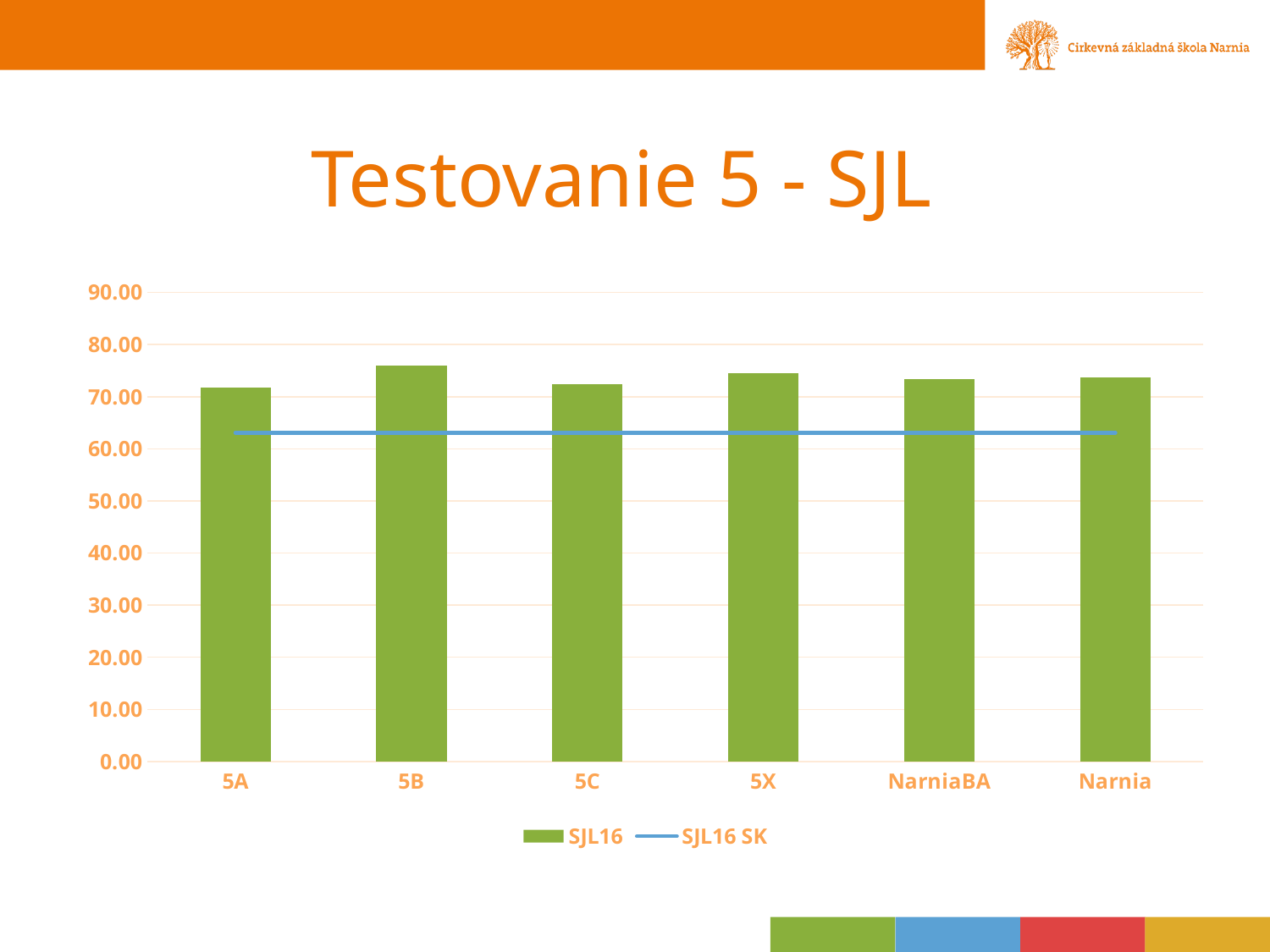
Which is larger, the SJL16 value for 5B or for 5A? 5B How many series does the chart's legend list? 2 What kind of chart is shown on the slide? combination bar and line chart Which is larger, the SJL16 value for 5X or for 5C? 5X Is the SJL16 value for 5A greater or less than 80? less Is the SJL16 SK line greater or less than 70? less Which series in the legend is drawn as a line? SJL16 SK How many categories are shown on the x axis of the chart? 6 Which category has the highest SJL16 bar? 5B Is the SJL16 value for Narnia greater or less than the SJL16 SK line? greater What is the title of the slide containing the chart? Testovanie 5 - SJL Is the SJL16 value for 5B greater or less than 70? greater